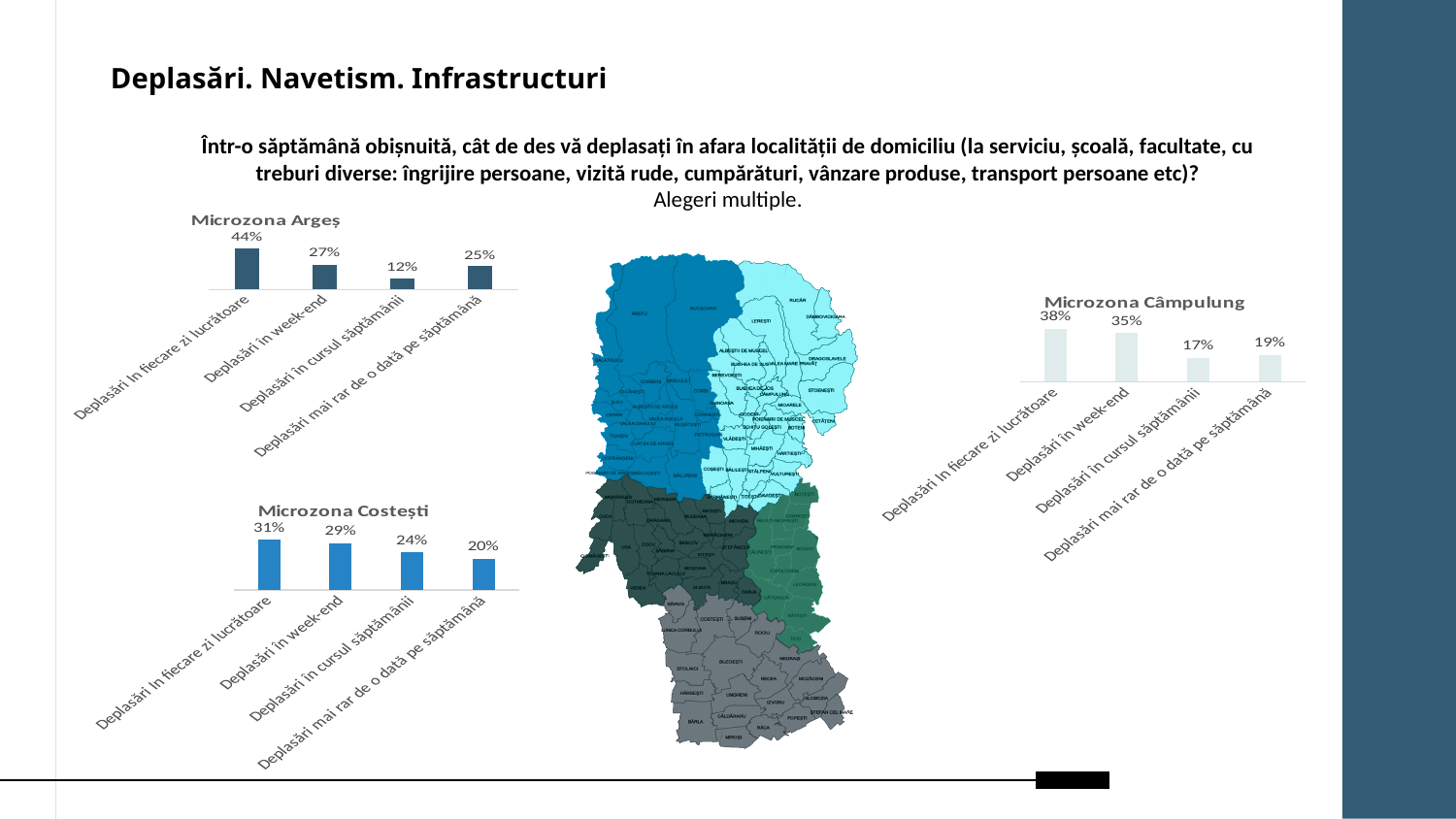
In the Microzona Câmpulung chart, which category has the lowest value? Deplasări în cursul săptămânii In the Microzona Costești chart, what is the value for "Deplasări în cursul săptămânii"? 24% How many categories does the Microzona Argeș chart show? 4 In the Microzona Argeș chart, which category has the lowest value? Deplasări în cursul săptămânii In the Microzona Costești chart, which category has the highest value? Deplasări în fiecare zi lucrătoare In the Microzona Argeș chart, what is the value for "Deplasări în fiecare zi lucrătoare"? 44% What type of chart is the Microzona Costești chart? Bar chart How many bar charts are shown on the slide? 3 In the Microzona Costești chart, what is the difference between "Deplasări în fiecare zi lucrătoare" and "Deplasări mai rar de o dată pe săptămână"? 11% In the Microzona Câmpulung chart, what is the value for "Deplasări în week-end"? 35% In the Microzona Argeș chart, what is the difference between "Deplasări în week-end" and "Deplasări mai rar de o dată pe săptămână"? 2% In the Microzona Câmpulung chart, which is larger: "Deplasări în cursul săptămânii" or "Deplasări mai rar de o dată pe săptămână"? Deplasări mai rar de o dată pe săptămână